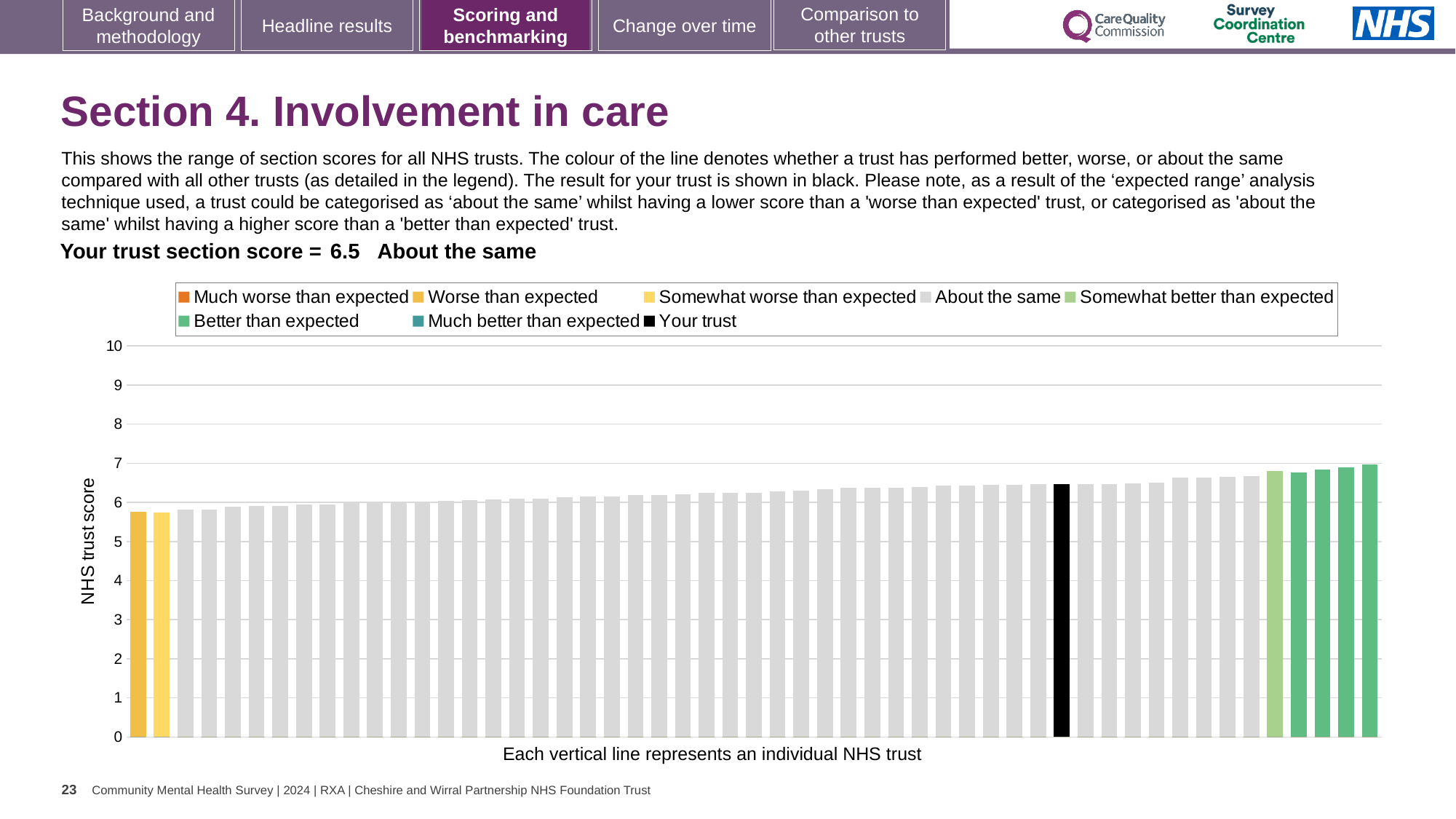
What is the section score for your trust shown on the slide? 6.5 How is your trust's section score categorised compared with other trusts? About the same Is the value for your trust (the black bar) greater or less than 7? less How many entries does the chart legend list? 8 Do the bar values rise or fall from left to right along the x axis? rise Is the value for your trust (the black bar) greater or less than 6? greater What is the label on the vertical axis of the chart? NHS trust score What colour is used for the bar representing your trust? black Is the value for the leftmost bar greater or less than 6? less What kind of chart is shown on the slide? bar chart